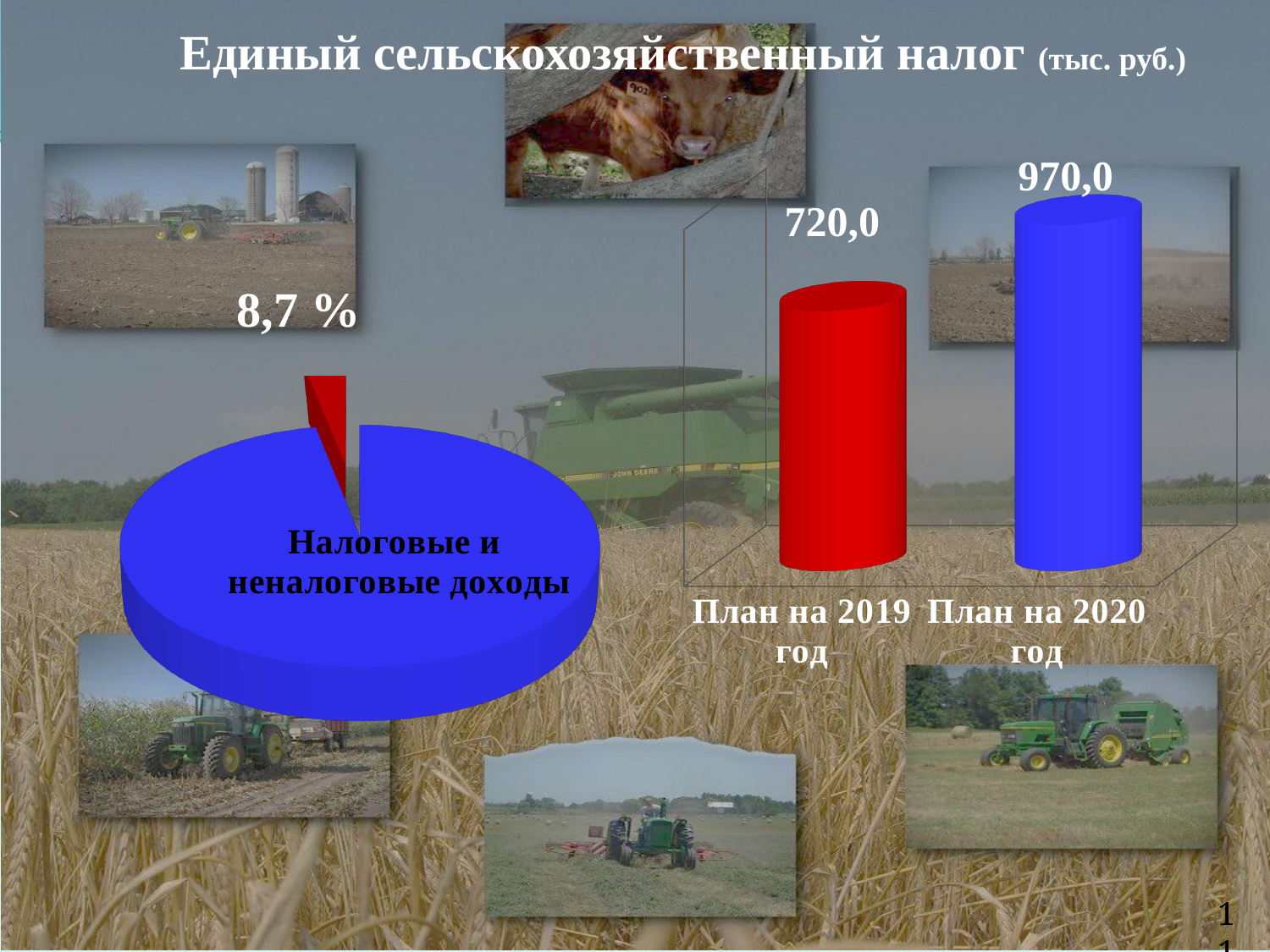
On the bar chart, which category has the lowest value? План на 2019 год On the bar chart, what is the value for План на 2020 год? 970,0 What kind of chart is the chart on the right side of the slide? Bar chart On the bar chart, which is larger: the value for План на 2019 год or План на 2020 год? План на 2020 год On the bar chart, what is the value for План на 2019 год? 720,0 On the bar chart, what is the difference between the values for План на 2020 год and План на 2019 год? 250,0 How many bars are shown on the bar chart? 2 What kind of chart is the chart on the left side of the slide? Pie chart On the bar chart, which category has the highest value? План на 2020 год On the bar chart, do the values rise or fall from План на 2019 год to План на 2020 год? Rise On the pie chart, what share is shown for the red slice? 8,7 %